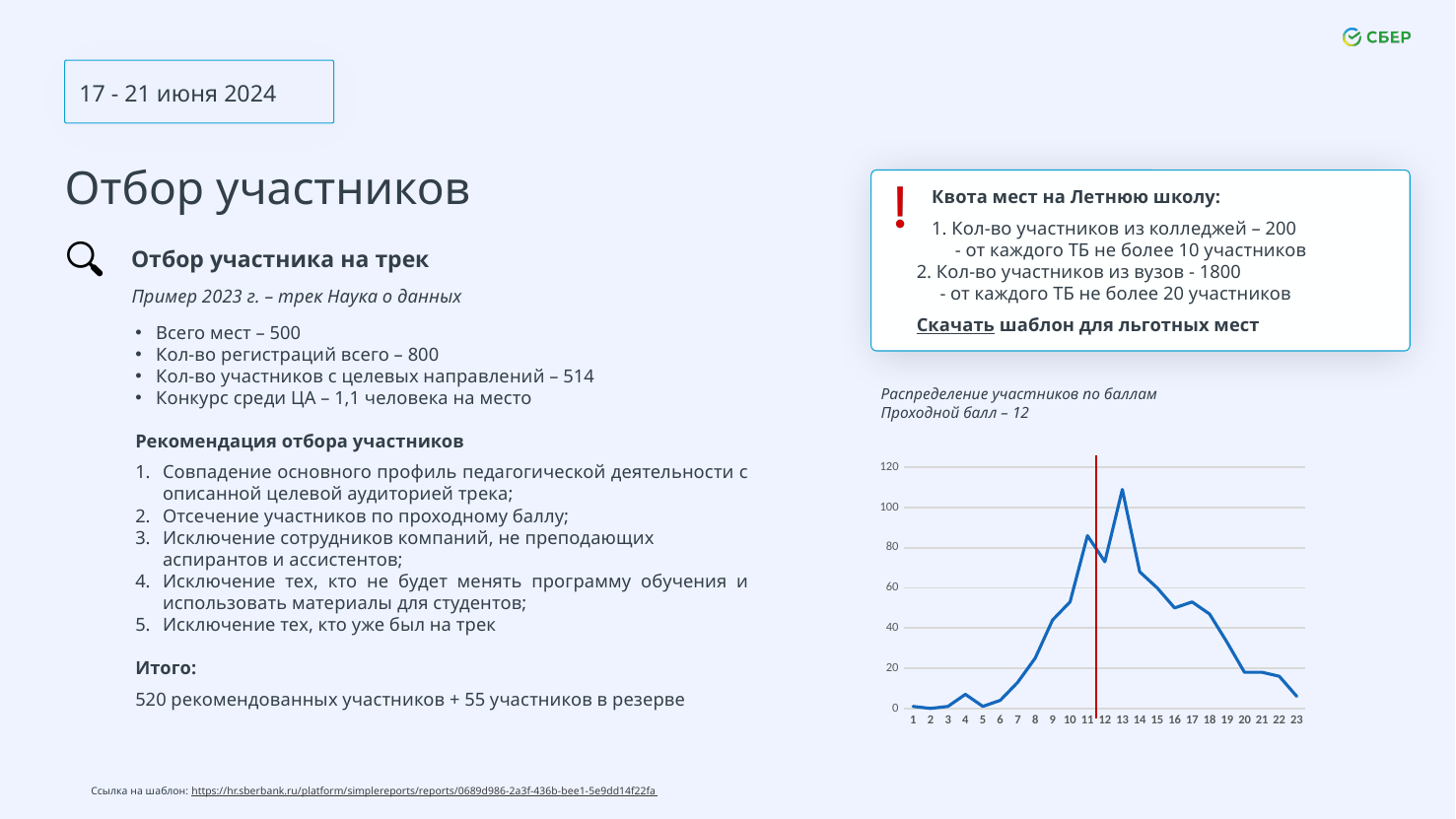
What kind of chart is shown on the slide? line chart Is the value at score 23 greater or less than 20? less What is the title of the chart on the slide? Распределение участников по баллам At which score on the x axis does the line reach its highest value? 13 Is the value at score 17 greater or less than 40? greater Is the value at score 11 greater or less than 80? greater What passing score (проходной балл) is stated above the chart? 12 Which score has the larger value, 13 or 11? 13 How many points (score values) are plotted along the x axis of the chart? 23 Do the values rise or fall along the x axis from score 13 to score 23? fall